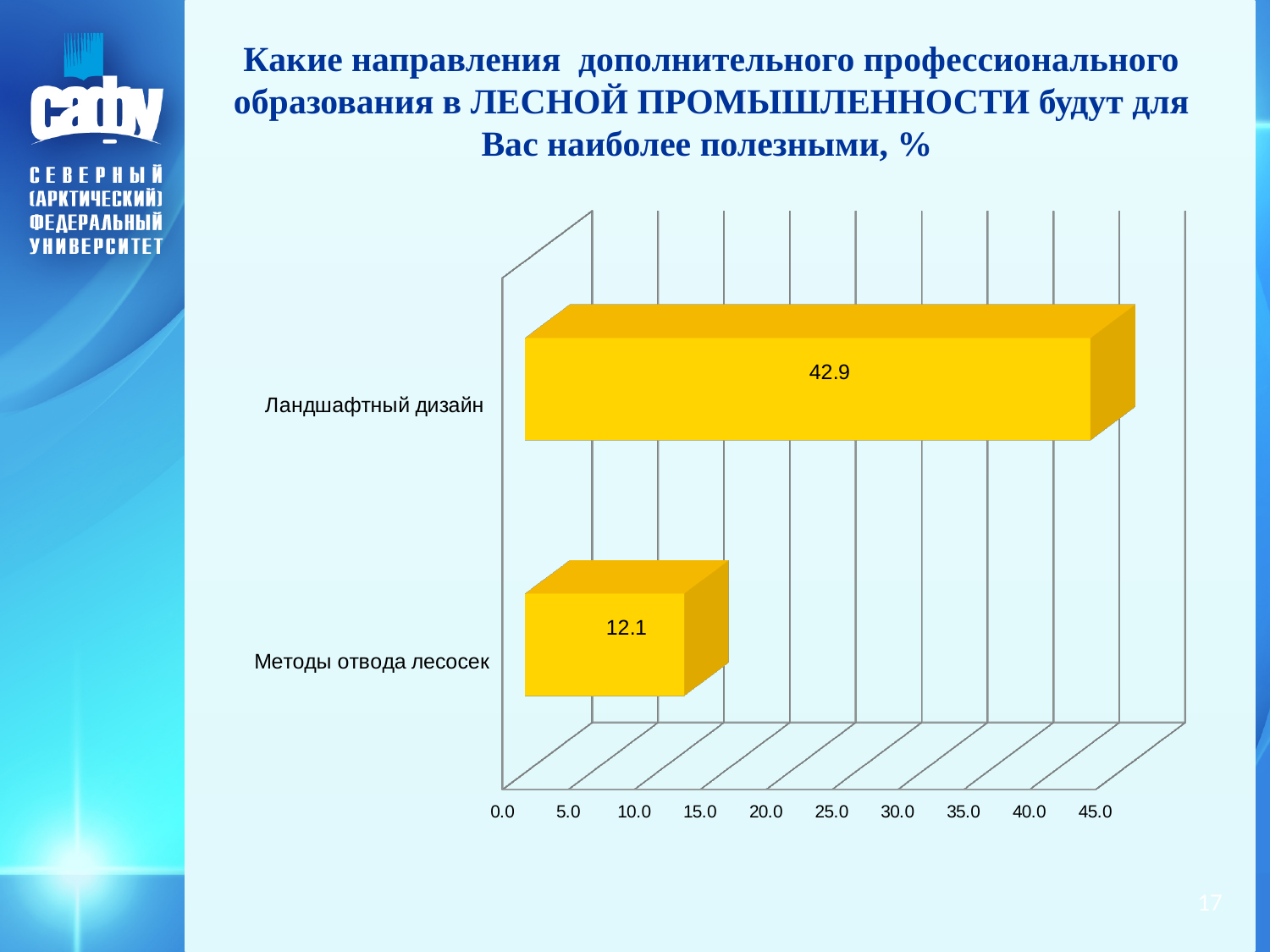
What is the value for Методы отвода лесосек? 12.1 What is the value for Ландшафтный дизайн? 42.9 Which category has the lowest value? Методы отвода лесосек What is the difference between the values for Ландшафтный дизайн and Методы отвода лесосек? 30.8 Which category has the highest value? Ландшафтный дизайн Is the value for Ландшафтный дизайн greater or less than 40.0? greater Is the value for Методы отвода лесосек greater or less than 15.0? less What kind of chart is shown on the slide? bar chart Which is larger, the value for Ландшафтный дизайн or the value for Методы отвода лесосек? Ландшафтный дизайн What is the maximum value shown on the horizontal axis? 45.0 How many categories are shown in the chart? 2 What colour are the bars in the chart? yellow